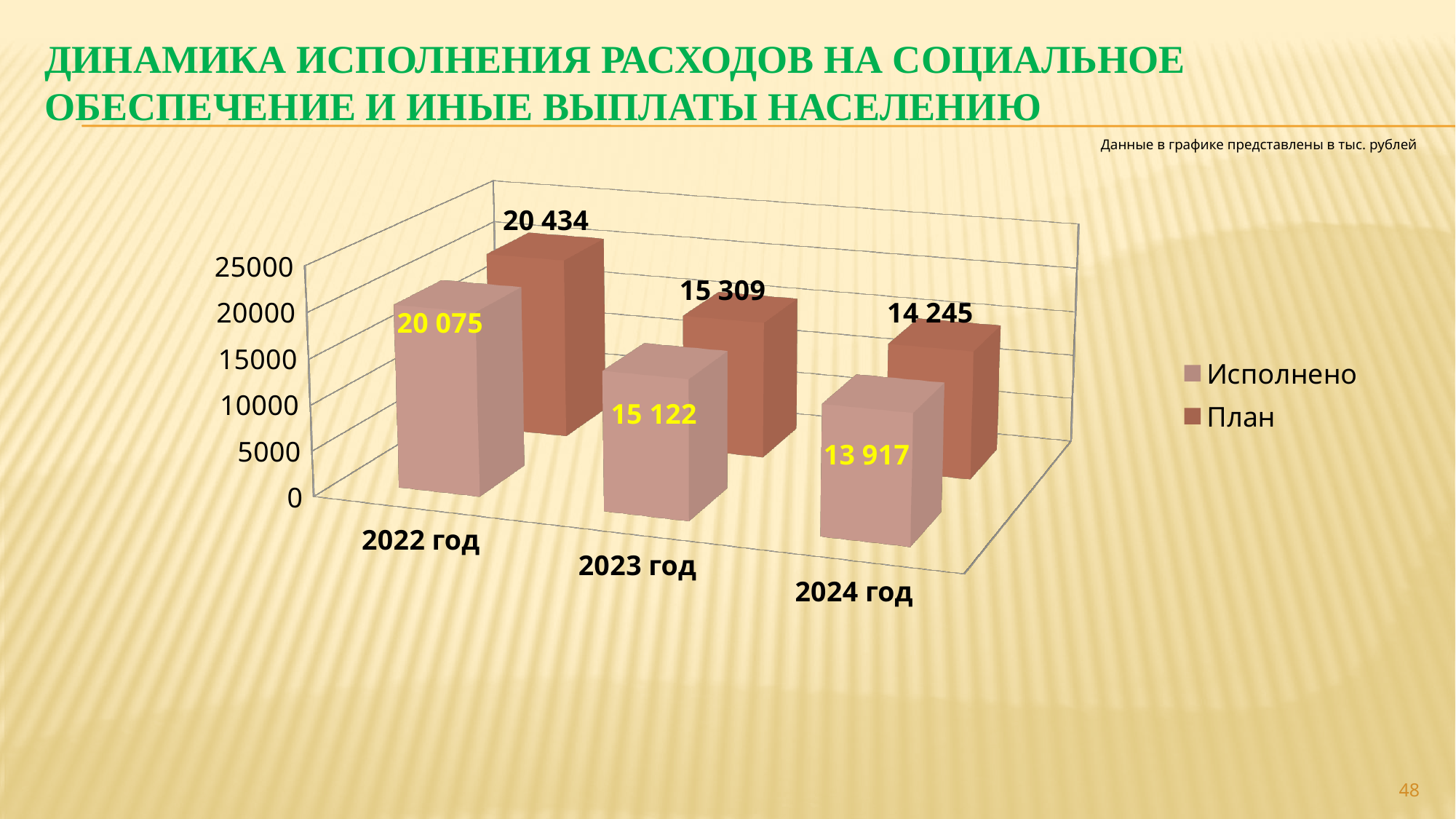
What is the value of План for 2023 год? 15 309 What is the value of Исполнено for 2024 год? 13 917 Do the Исполнено values rise or fall from 2022 год to 2024 год? fall Which is larger for 2023 год: План or Исполнено? План What is the difference between План and Исполнено for 2024 год? 328 What is the value of Исполнено for 2022 год? 20 075 What is the value of План for 2022 год? 20 434 Which year has the lowest Исполнено value? 2024 год What is the difference between План and Исполнено for 2022 год? 359 Which year has the highest План value? 2022 год How many years are shown on the x axis? 3 How many series does the legend list? 2